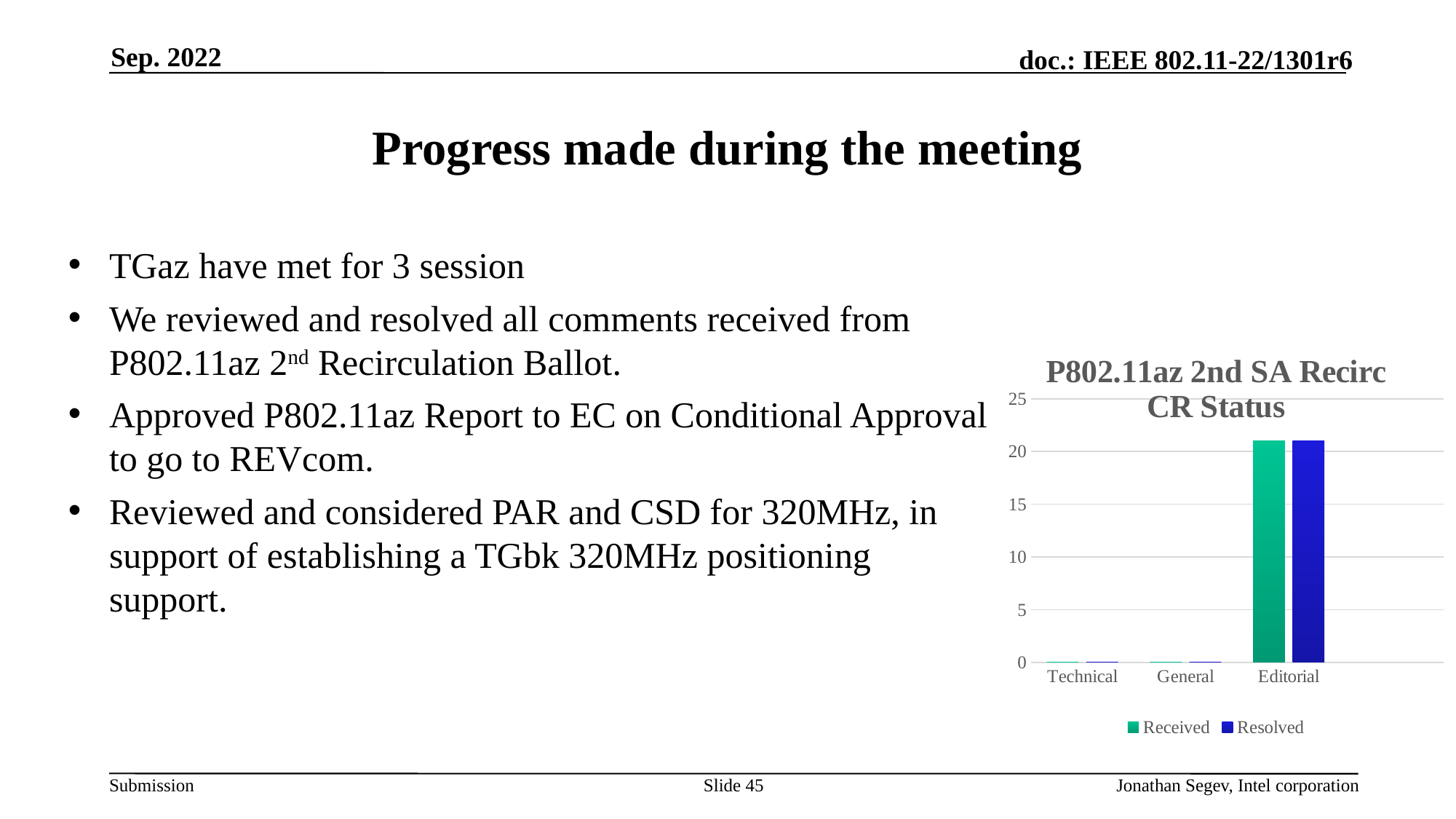
Is the Received value for Technical greater or less than 5? less Which category has the highest Resolved value? Editorial Which category has the highest Received value? Editorial How many categories are shown on the x axis of the chart? 3 How many series does the chart legend list? 2 Which is larger, the Received value for Editorial or the Received value for Technical? Editorial Is the Resolved value for Editorial greater or less than 25? less What kind of chart is shown on the slide? bar chart Is the Resolved value for General greater or less than 5? less What are the series names listed in the chart legend? Received, Resolved What is the title of the chart? P802.11az 2nd SA Recirc CR Status